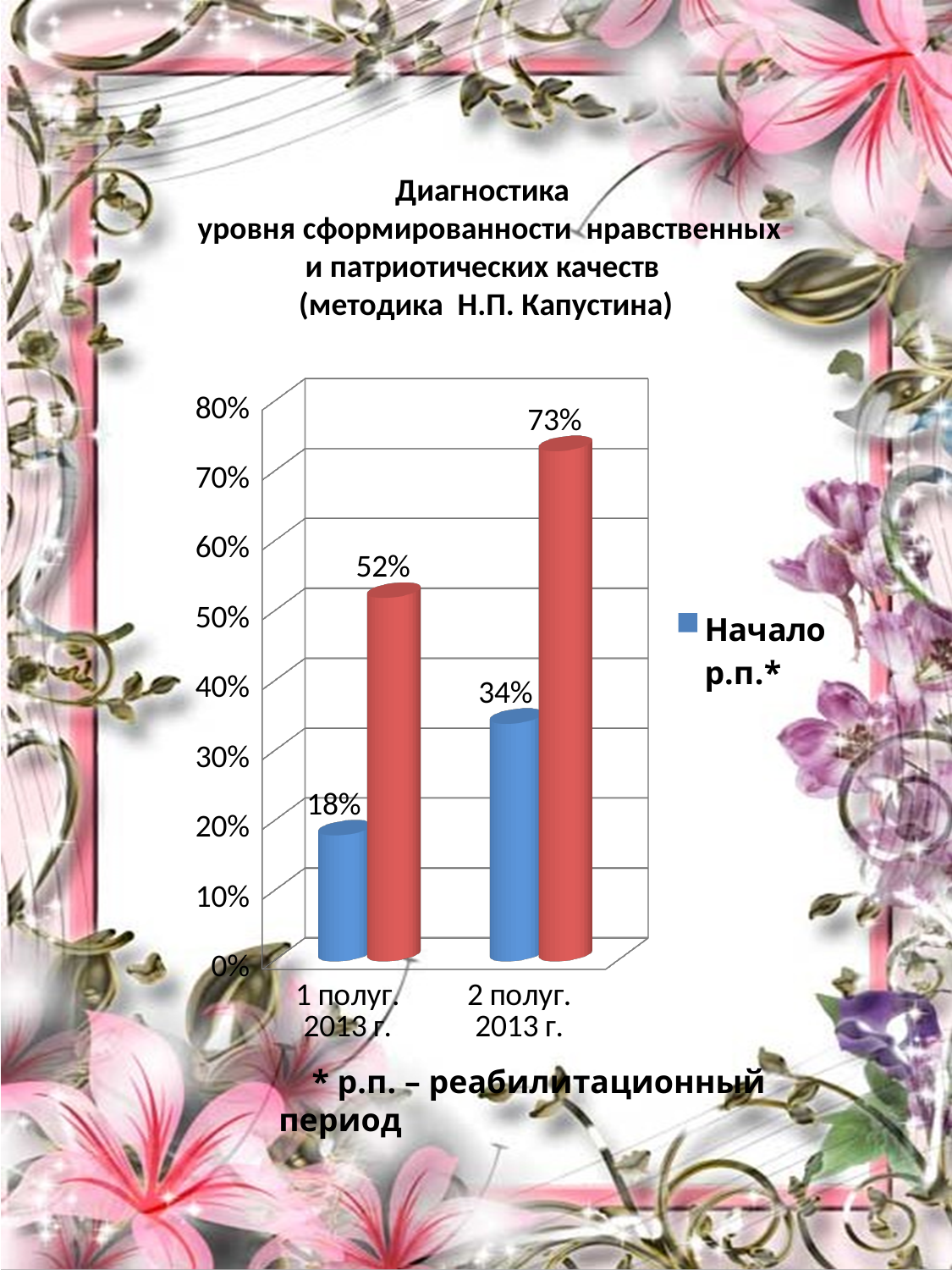
What is the value of the Начало р.п.* series for 1 полуг. 2013 г.? 18% What is the difference between the red bar values for 2 полуг. 2013 г. and 1 полуг. 2013 г.? 21 percentage points What is the value of the red bar for 1 полуг. 2013 г.? 52% What is the lowest value shown on the chart? 18% What type of chart is shown on the slide? Bar chart What is the value of the red bar for 2 полуг. 2013 г.? 73% For the Начало р.п.* series, which category has the larger value: 1 полуг. 2013 г. or 2 полуг. 2013 г.? 2 полуг. 2013 г. What is the highest value shown on the chart? 73% How many categories are shown on the x axis? 2 Does the Начало р.п.* series rise or fall from 1 полуг. 2013 г. to 2 полуг. 2013 г.? Rise By how many percentage points does the Начало р.п.* value for 2 полуг. 2013 г. exceed that for 1 полуг. 2013 г.? 16 percentage points What is the value of the Начало р.п.* series for 2 полуг. 2013 г.? 34%